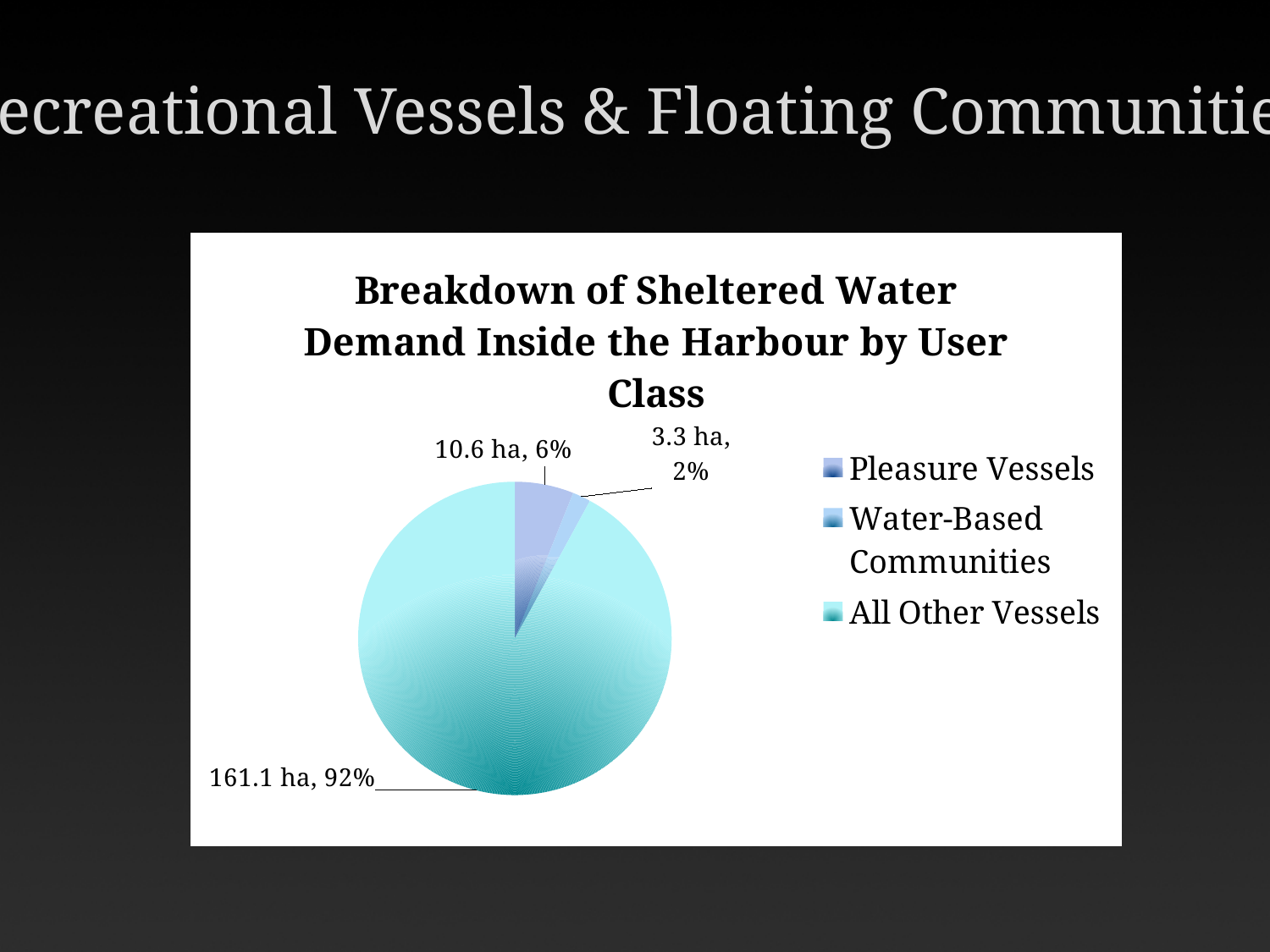
Which is larger, the area for Pleasure Vessels or the area for Water-Based Communities? Pleasure Vessels Which user class has the largest slice of the pie? All Other Vessels What share of the pie does Pleasure Vessels represent? 6% What share of the pie does All Other Vessels represent? 92% What kind of chart is shown on the slide? Pie chart Which user class has the smallest slice of the pie? Water-Based Communities What area in hectares is shown for All Other Vessels? 161.1 ha What area in hectares is shown for Water-Based Communities? 3.3 ha What is the title of the chart? Breakdown of Sheltered Water Demand Inside the Harbour by User Class What area in hectares is shown for Pleasure Vessels? 10.6 ha How many categories does the legend list? 3 What is the difference in hectares between Pleasure Vessels and Water-Based Communities? 7.3 ha